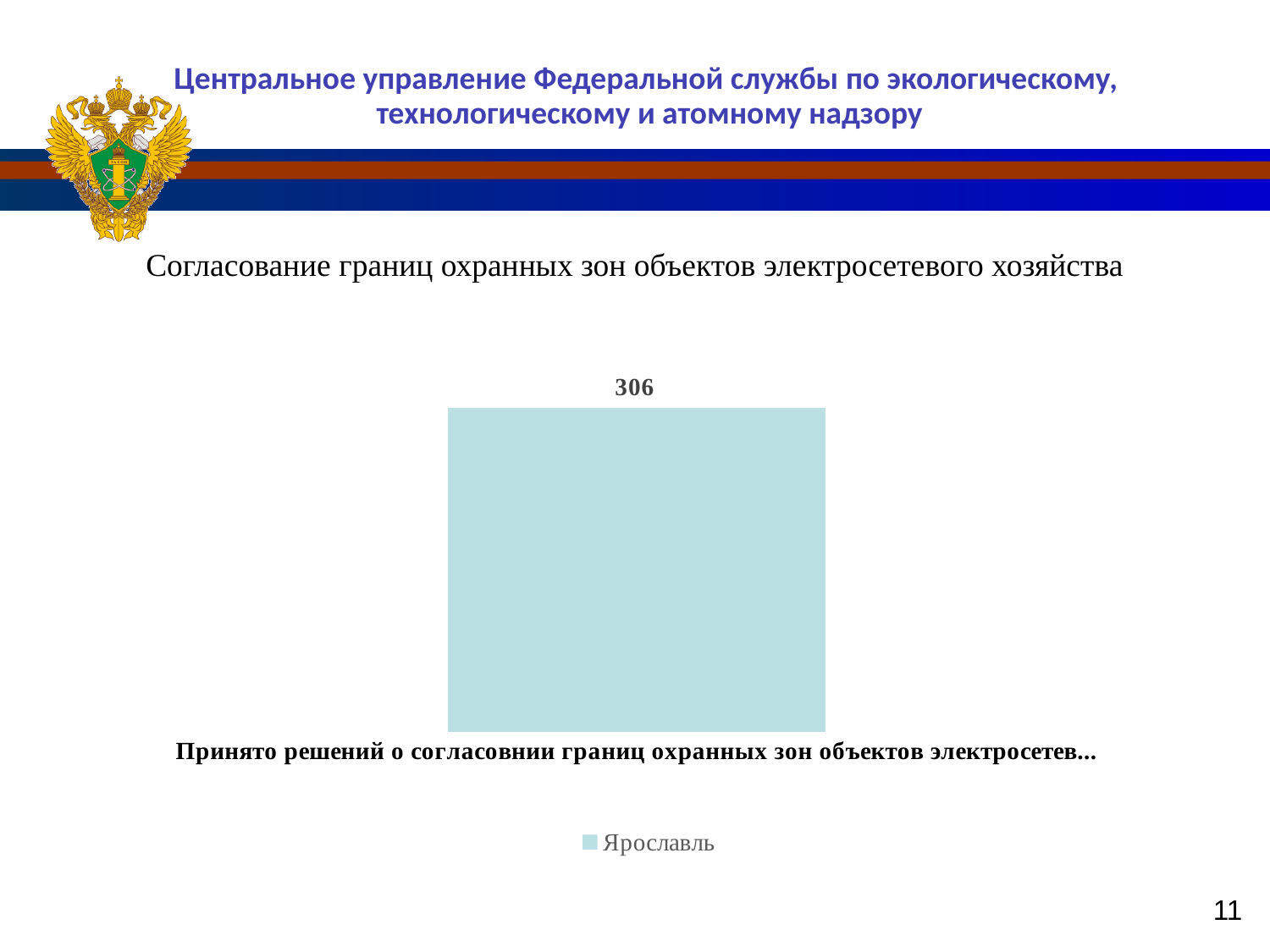
How many series does the legend list? 1 How many bars does the chart have? 1 Which series is listed in the chart legend? Ярославль What is the title of the slide above the chart? Согласование границ охранных зон объектов электросетевого хозяйства Is the value for Ярославль greater or less than 300? greater What kind of chart is shown on the slide? bar chart What value is shown for Ярославль in the chart? 306